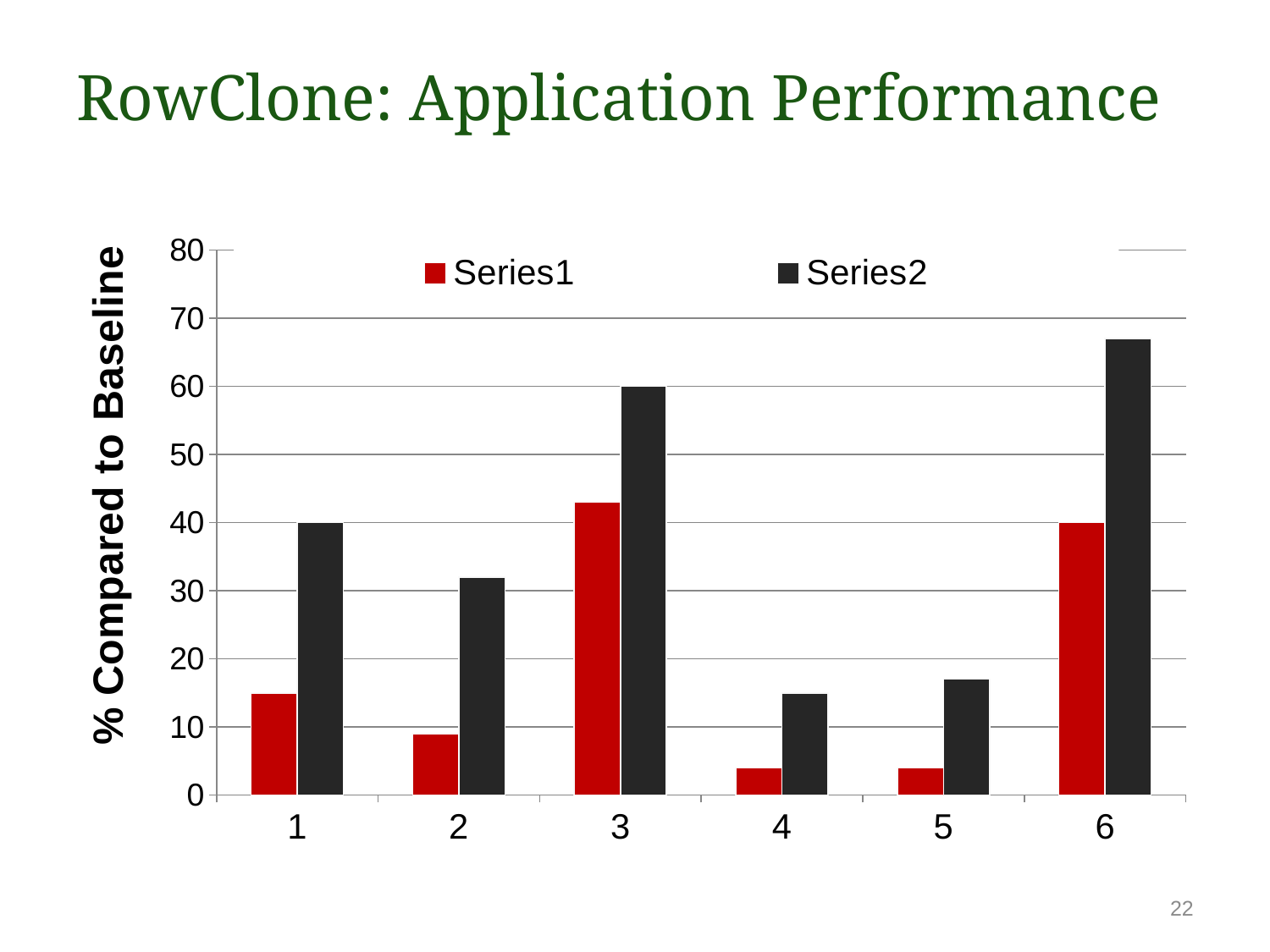
Is the Series2 value for category 2 greater or less than 30? greater For which category is the Series2 value highest? 6 Which colour represents Series1 in the chart? red What is the y-axis title of the chart? % Compared to Baseline How many categories are shown on the x axis? 6 How many series does the legend list? 2 For category 3, which series has the larger value, Series1 or Series2? Series2 Is the Series1 value for category 4 greater or less than 10? less Is the Series2 value for category 6 greater or less than 60? greater What kind of chart is shown on the slide? bar chart For which category is the Series1 value highest? 3